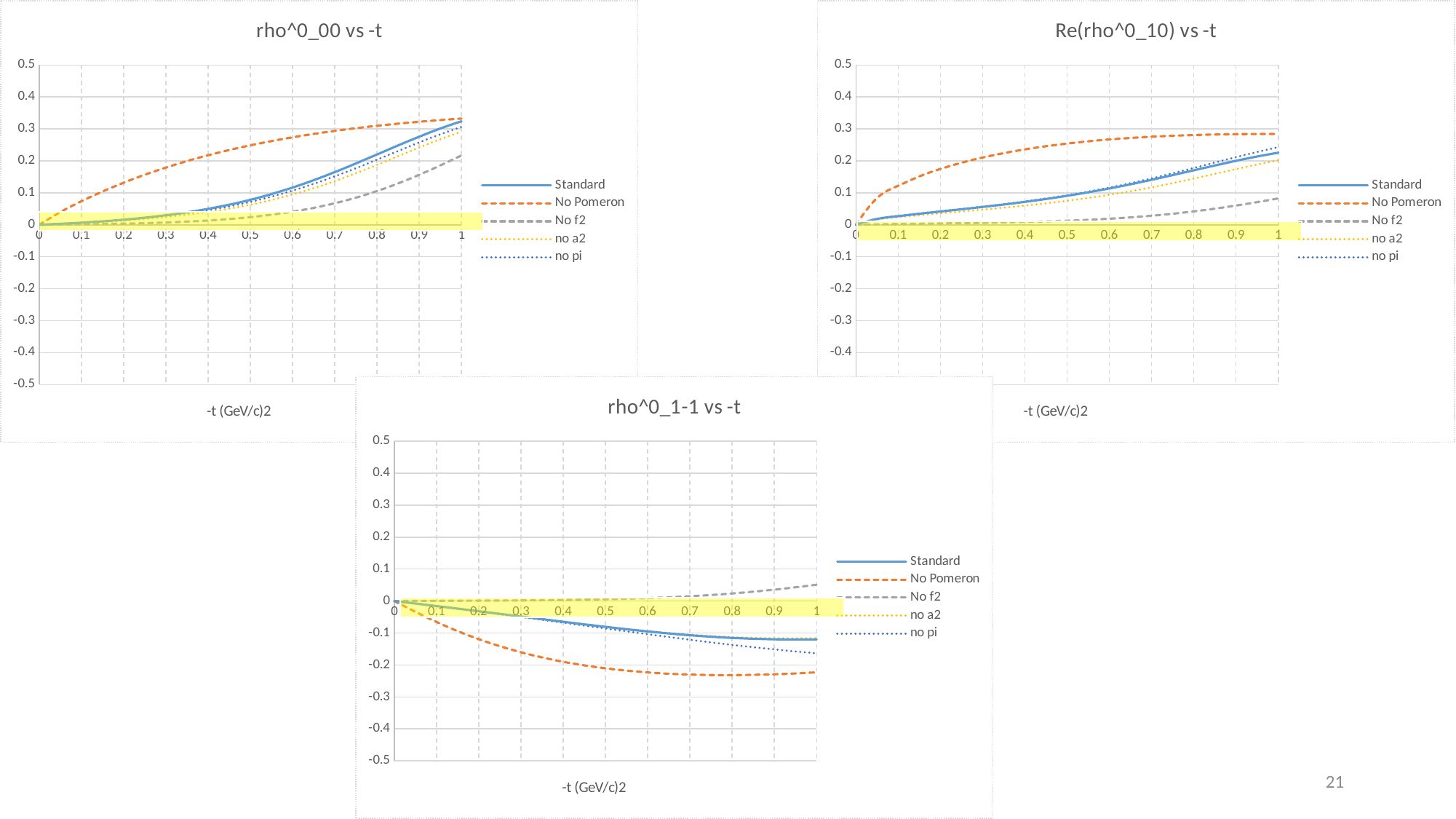
In the chart titled "rho^0_1-1 vs -t", at -t = 1, which is larger: the No f2 series or the No Pomeron series? No f2 In the chart titled "Re(rho^0_10) vs -t", which series has the lowest value at -t = 1? No f2 What kind of chart is the chart titled "rho^0_00 vs -t"? line chart In the chart titled "rho^0_00 vs -t", is the value of the No Pomeron series at -t = 0.5 greater or less than 0.2? greater In the chart titled "rho^0_1-1 vs -t", which series has the lowest value at -t = 1? No Pomeron In the chart titled "Re(rho^0_10) vs -t", which series has the highest value at -t = 1? No Pomeron In the chart titled "rho^0_00 vs -t", which series has the lowest value at -t = 1? No f2 What is the x-axis label of the chart titled "rho^0_1-1 vs -t"? -t (GeV/c)2 In the chart titled "Re(rho^0_10) vs -t", is the value of the No f2 series at -t = 1 greater or less than 0.1? less In the chart titled "rho^0_1-1 vs -t", is the value of the No Pomeron series at -t = 1 greater or less than -0.2? less How many series does the legend of the chart titled "Re(rho^0_10) vs -t" list? 5 In the chart titled "rho^0_1-1 vs -t", does the No Pomeron series rise or fall as -t increases from 0 to 0.5? fall